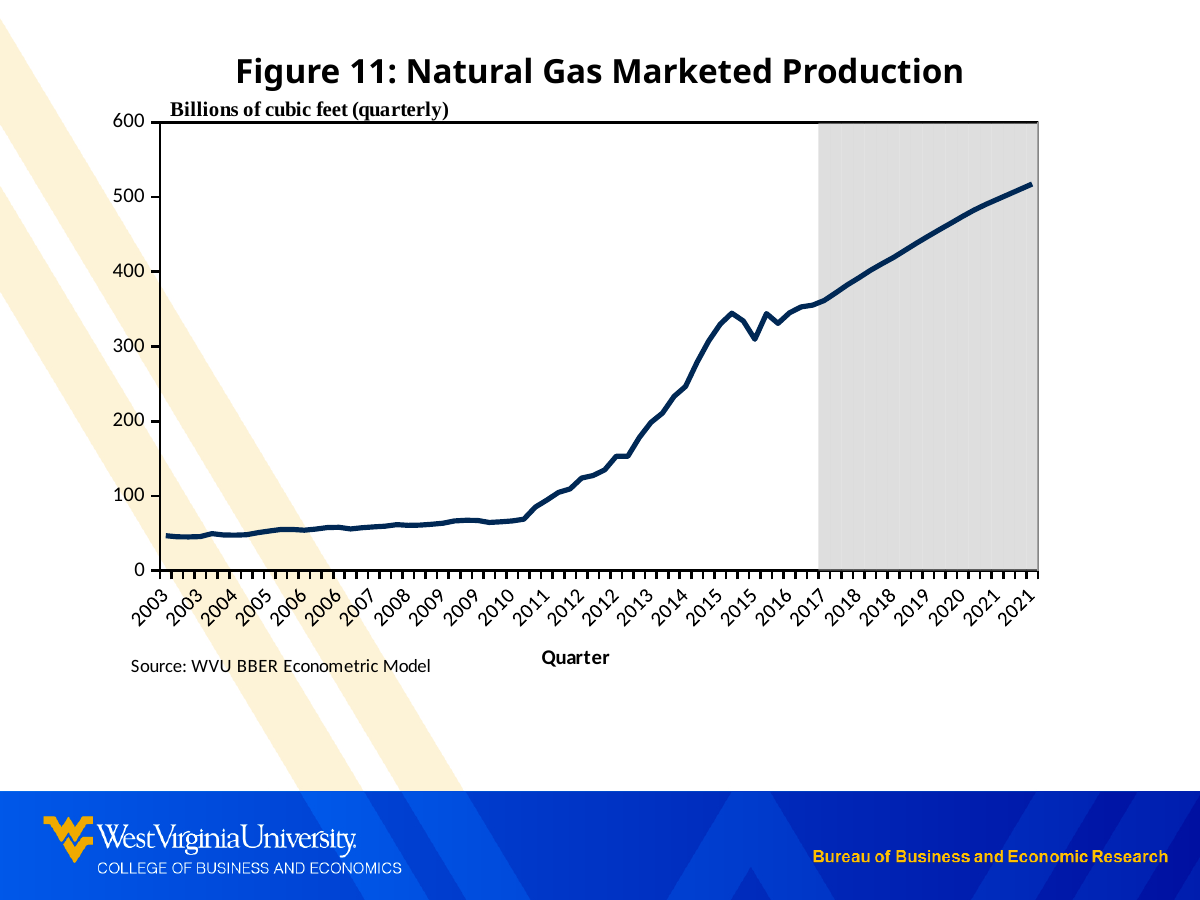
What unit is shown on the vertical axis of the chart? Billions of cubic feet (quarterly) Is the value at 2019 greater or less than 400? greater Is the value at 2017 greater or less than 300? greater What is the title of the chart? Figure 11: Natural Gas Marketed Production Is the value at the end of 2021 greater or less than 500? greater In which year does the line reach its highest value? 2021 Overall, do the values rise or fall from 2003 to 2021? rise Which is larger, the value at 2021 or the value at 2003? 2021 What kind of chart is shown on the slide? line chart